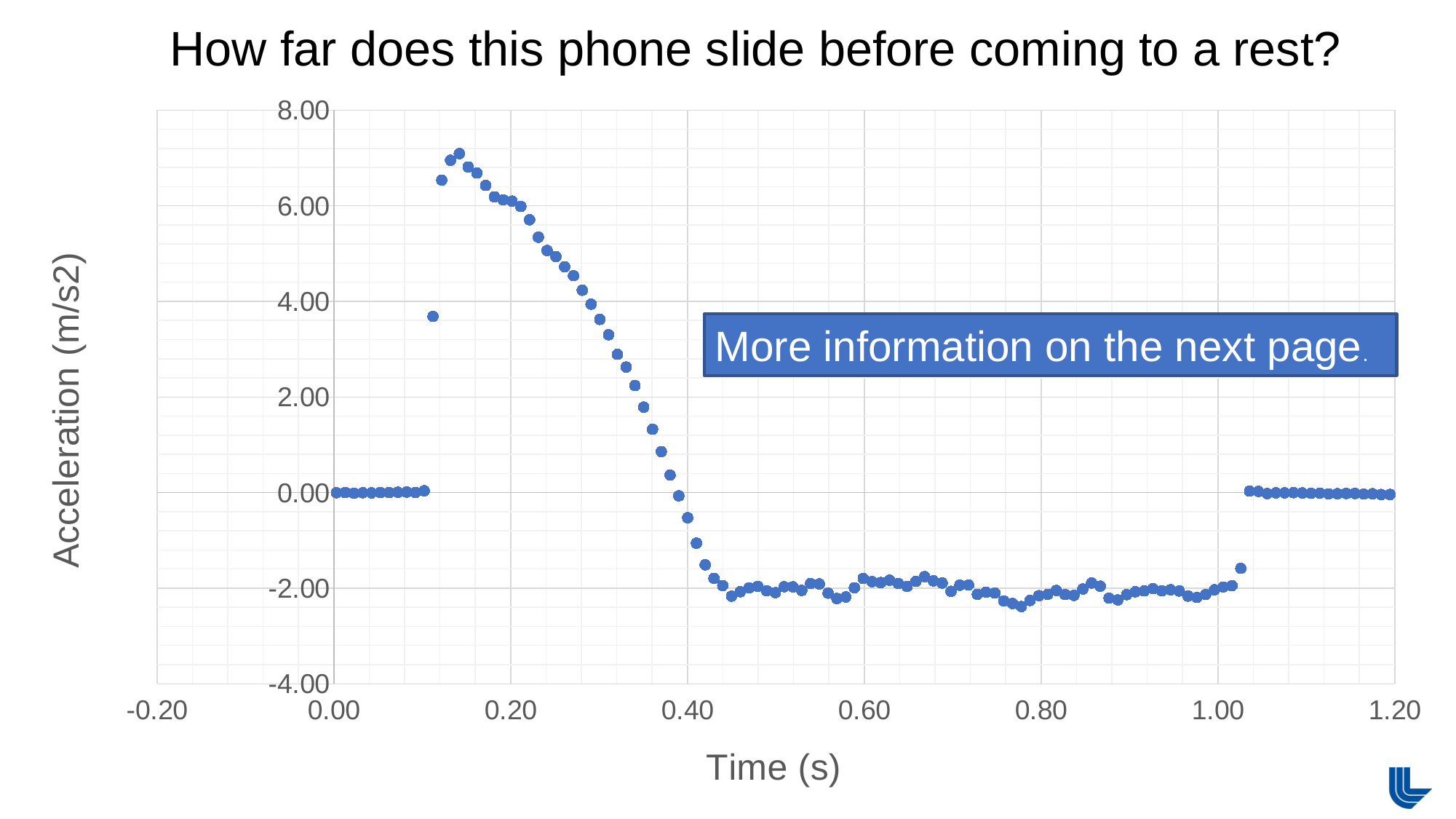
Which is larger, the acceleration at time 0.20 s or at time 0.60 s? 0.20 s Is the highest plotted acceleration greater or less than 6.00 m/s2? greater Is the acceleration at time 1.10 s greater or less than -2.00 m/s2? greater Which is larger, the acceleration at time 0.00 s or at time 0.80 s? 0.00 s What is the label of the x axis? Time (s) Between time 0.20 s and 0.40 s, does the acceleration rise or fall? fall Is the lowest plotted acceleration greater or less than -2.00 m/s2? less What is the label of the y axis? Acceleration (m/s2) What kind of chart is shown on the slide? scatter chart